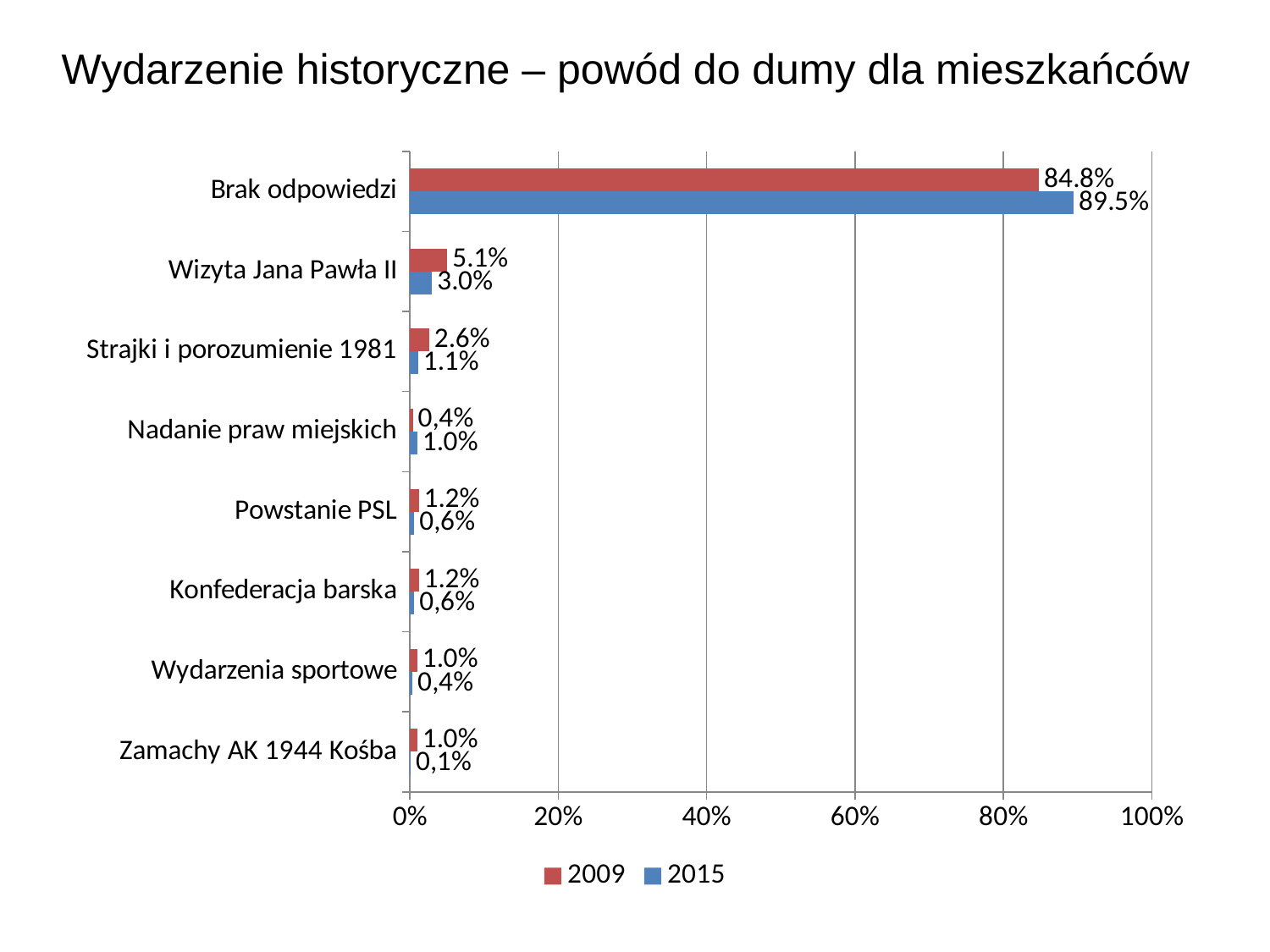
Which series is shown in blue in the legend? 2015 What is the 2015 value for Brak odpowiedzi? 89.5% What is the 2009 value for Wizyta Jana Pawła II? 5.1% How many categories are shown on the chart? 8 Which category has the highest 2009 value? Brak odpowiedzi For Wizyta Jana Pawła II, which is larger: the 2009 value or the 2015 value? 2009 Which category has the lowest 2015 value? Zamachy AK 1944 Kośba What type of chart is shown on the slide? bar chart How many series does the legend list? 2 What is the difference between the 2015 and 2009 values for Brak odpowiedzi? 4.7% What is the 2015 value for Strajki i porozumienie 1981? 1.1% What is the 2009 value for Nadanie praw miejskich? 0,4%